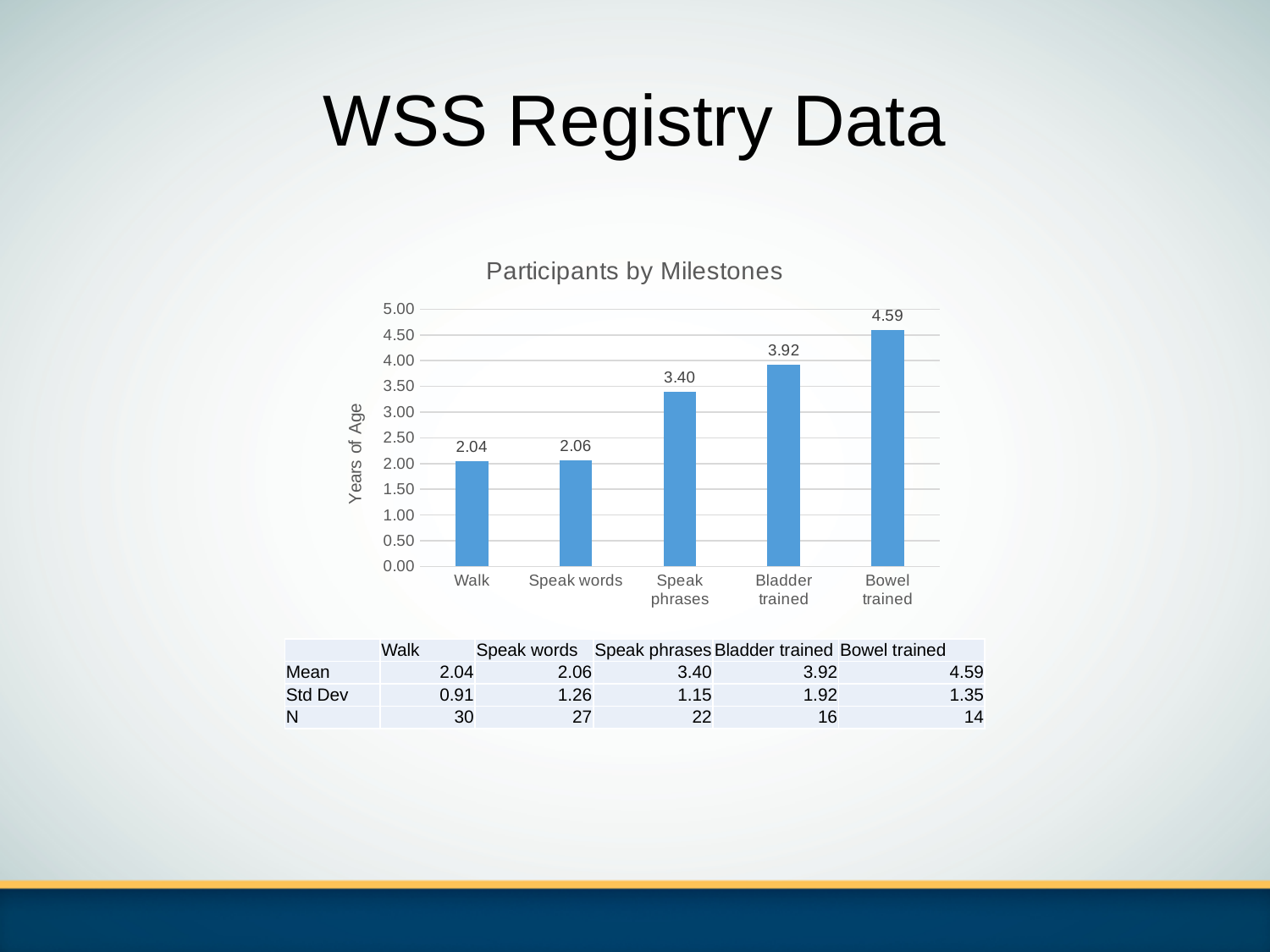
What is the difference between the values for Bladder trained and Speak phrases? 0.52 Which milestone has the highest value in the chart? Bowel trained What is the label of the vertical axis of the chart? Years of Age What is the difference between the values for Bowel trained and Walk? 2.55 What kind of chart is shown on the slide? bar chart Which is larger, the value for Speak phrases or the value for Speak words? Speak phrases Is the value for Bowel trained greater or less than 4.50? greater What is the value for Bladder trained in the chart? 3.92 Which milestone has the lowest value in the chart? Walk What is the value for Walk in the Participants by Milestones chart? 2.04 What is the value for Speak phrases in the chart? 3.40 How many milestone categories are shown in the chart? 5